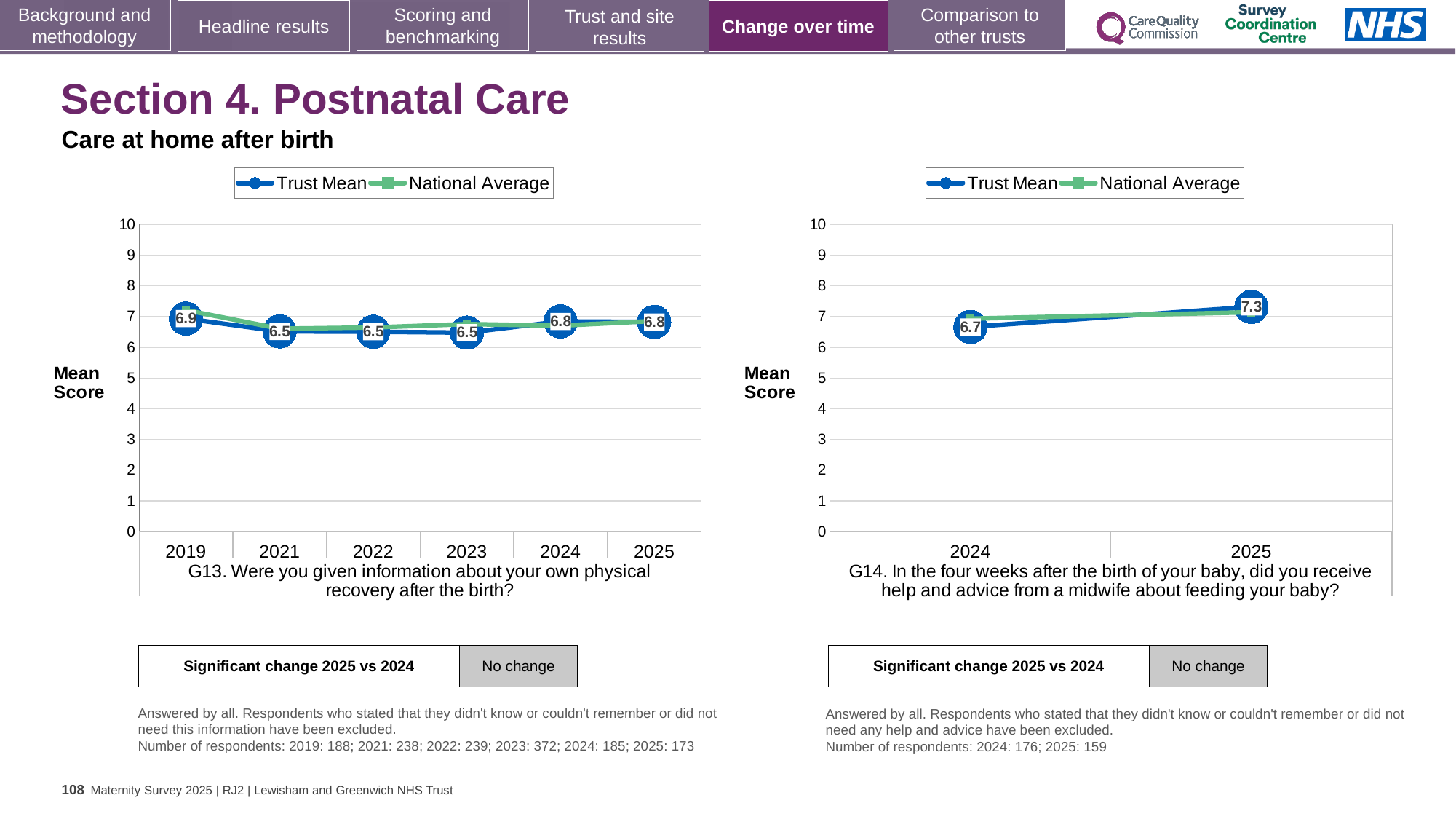
On the G13 chart (left), how many years are plotted on the x axis? 6 On the G14 chart (right), does the Trust Mean rise or fall from 2024 to 2025? rise How many series does the legend of the G14 chart (right) list? 2 On the G14 chart (right), what is the Trust Mean score for 2024? 6.7 On the G13 chart (left), what is the Trust Mean score for 2025? 6.8 On the G13 chart (left), what is the difference between the Trust Mean scores for 2019 and 2021? 0.4 On the G13 chart (left), is the Trust Mean score for 2023 greater or less than 7? less On the G13 chart (left), which year has the highest Trust Mean score? 2019 On the G13 chart (left), what is the Trust Mean score for 2019? 6.9 On the G14 chart (right), what is the difference between the Trust Mean scores for 2025 and 2024? 0.6 On the G14 chart (right), what is the Trust Mean score for 2025? 7.3 What kind of chart is the G13 chart (left)? line chart